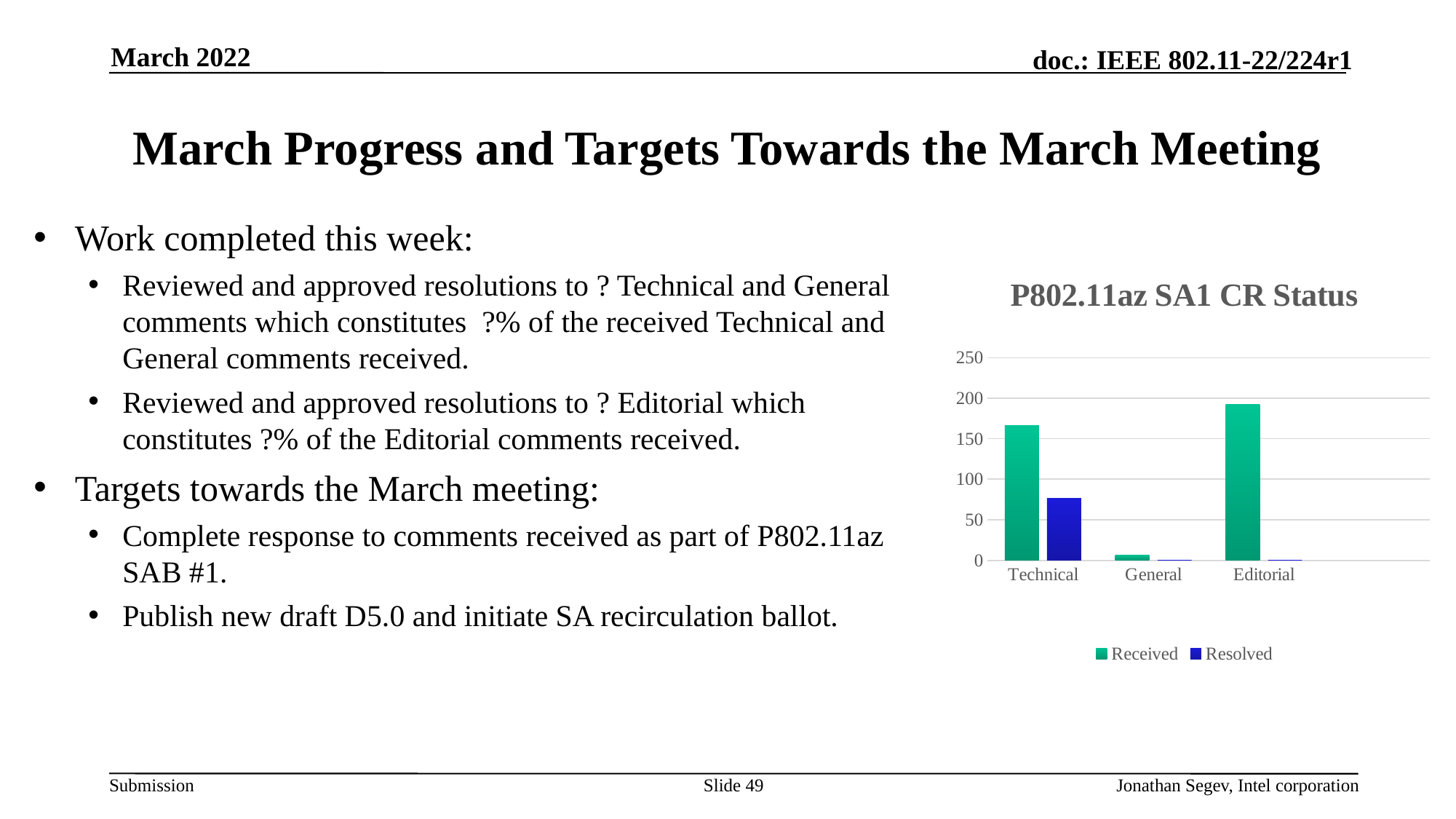
What is the title of the chart? P802.11az SA1 CR Status Is the Received value for Technical greater or less than 150? greater Which series is shown in blue in the chart legend? Resolved Is the Received value for General greater or less than 50? less Which category has the highest Received value? Editorial What kind of chart is shown on the slide? bar chart Is the Received value for Editorial greater or less than 200? less Which category has the lowest Received value? General How many categories are shown on the x axis of the chart? 3 Which is larger, the Received value for Editorial or the Received value for Technical? Editorial How many series does the chart legend list? 2